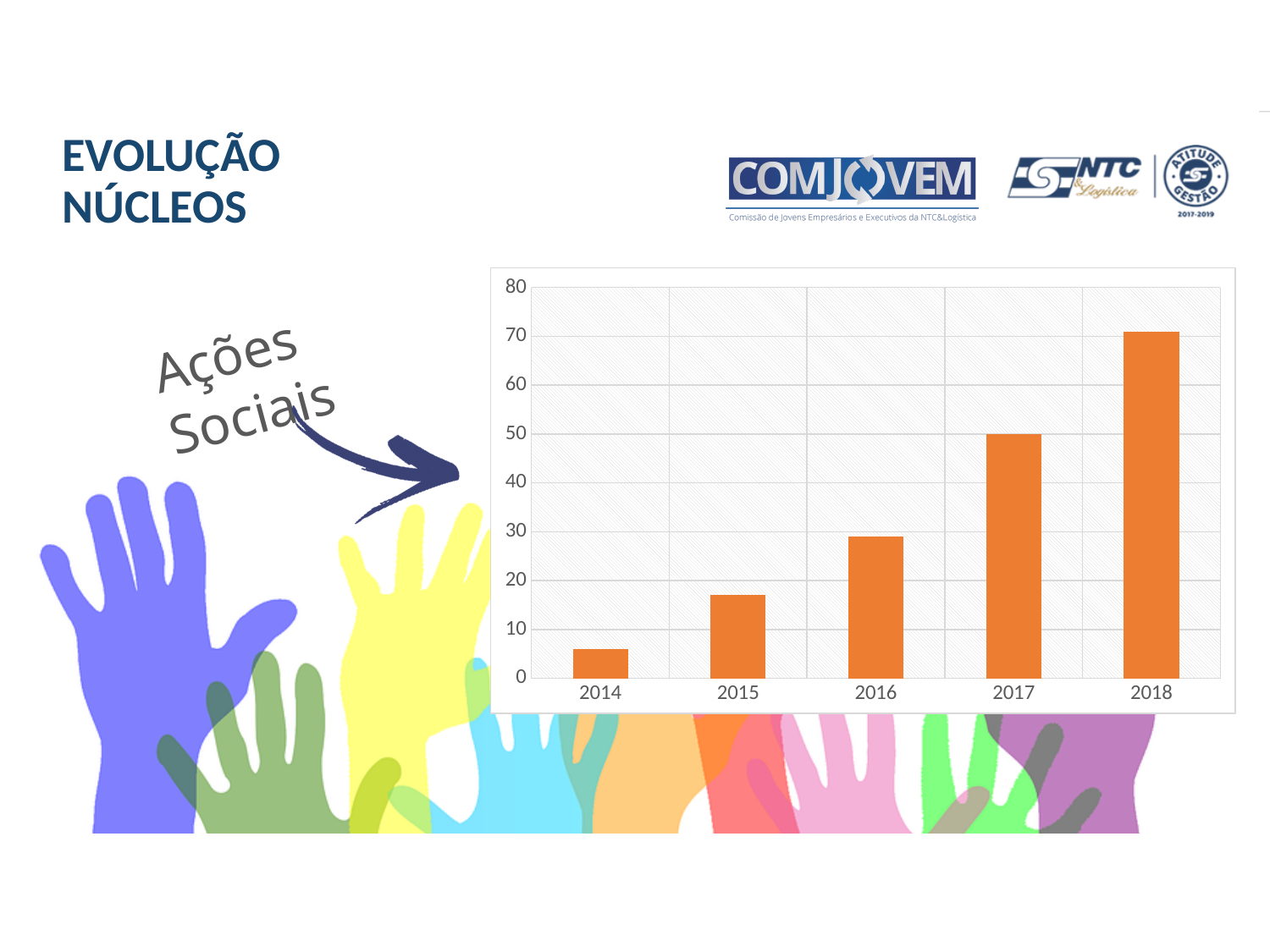
Which is larger, the value for 2016 or the value for 2017? 2017 What kind of chart is shown on the slide? bar chart Is the value for 2014 greater or less than 10? less Which year has the lowest bar in the chart? 2014 Is the value for 2015 greater or less than 20? less Do the values rise or fall from 2014 to 2018? rise Is the value for 2016 greater or less than 20? greater What label with an arrow points to the chart? Ações Sociais Which year has the highest bar in the chart? 2018 What is the value for 2017 in the chart? 50 How many years are shown on the x axis of the chart? 5